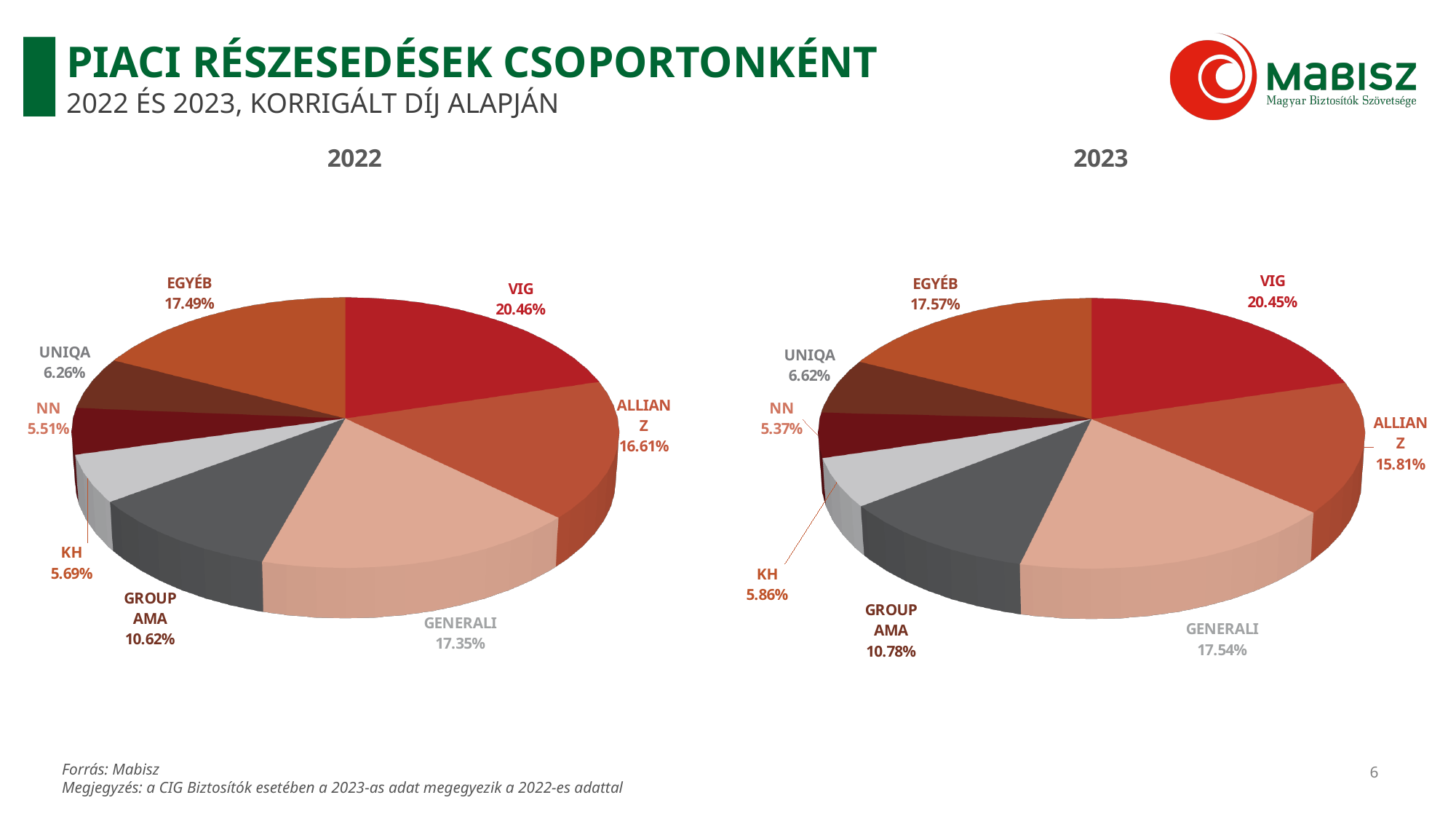
What type of chart is used to show the 2022 market shares? Pie chart In the 2023 pie chart, which group has the smallest share? NN In the 2023 pie chart, which is larger: the share of GENERALI or the share of EGYÉB? EGYÉB In the 2022 pie chart, what is the market share of VIG? 20.46% In the 2022 pie chart, which group has the largest share? VIG In the 2023 pie chart, what is the market share of ALLIANZ? 15.81% In the 2022 pie chart, how many percentage points larger is VIG's share than ALLIANZ's share? 3.85 percentage points In the 2022 pie chart, which group has the smallest share? NN How many slices does the 2023 pie chart have? 8 In the 2022 pie chart, which is larger: the share of UNIQA or the share of KH? UNIQA What is the title of the slide? PIACI RÉSZESEDÉSEK CSOPORTONKÉNT In the 2023 pie chart, what is the market share of GROUPAMA? 10.78%